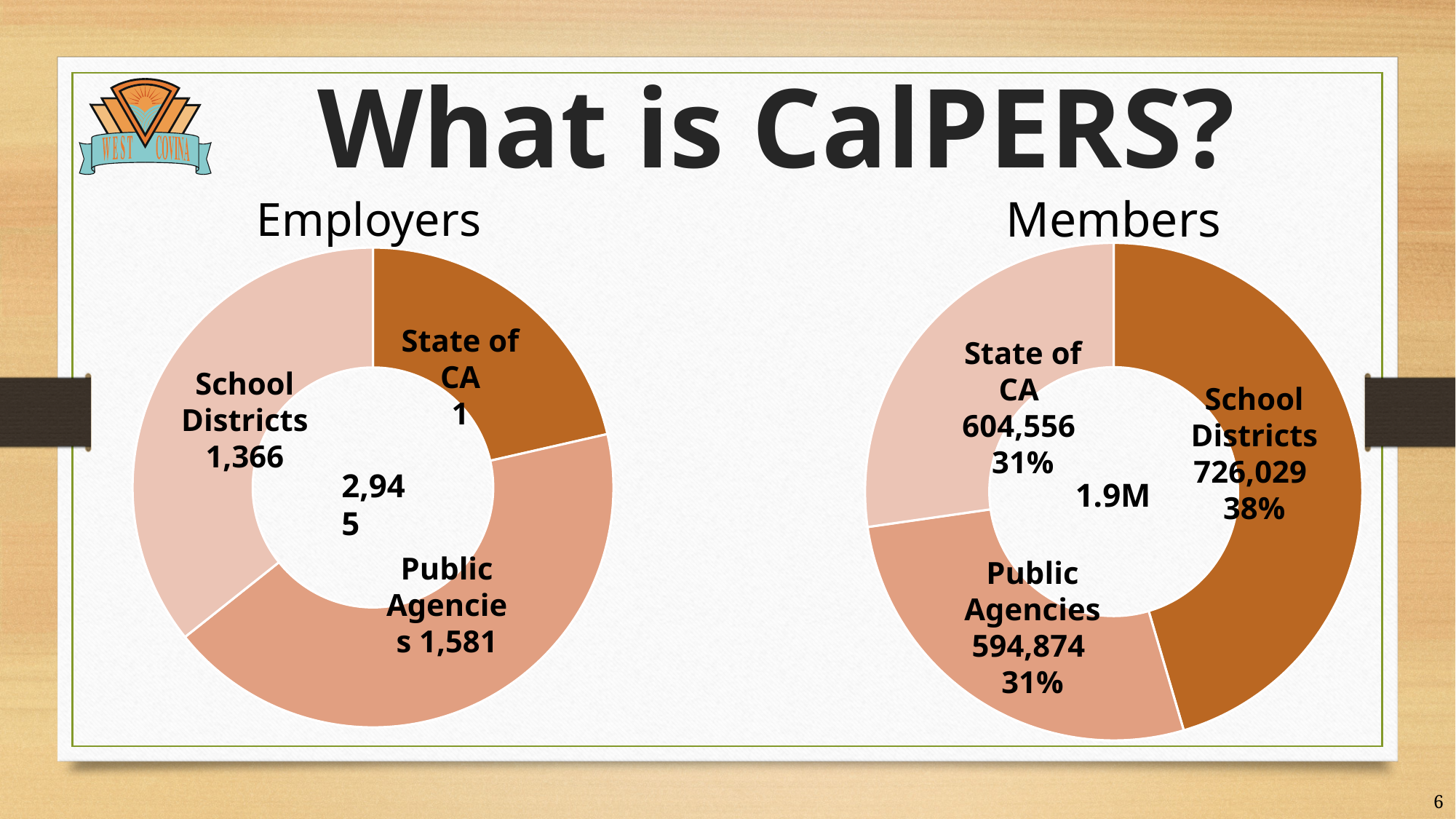
In the Members chart, what is the value for State of CA? 604,556 In the Members chart, what percentage share do School Districts have? 38% How many categories does the Members chart show? 3 In the Members chart, what percentage share do Public Agencies have? 31% In the Members chart, which category has the lowest value? Public Agencies In the Employers chart, which is larger, Public Agencies or School Districts? Public Agencies In the Employers chart, what is the value for School Districts? 1,366 In the Members chart, what is the value for School Districts? 726,029 In the Members chart, what is the difference between School Districts and Public Agencies? 131,155 In the Members chart, which category has the highest value? School Districts In the Employers chart, what is the value for Public Agencies? 1,581 What type of chart is used for Employers? Doughnut chart